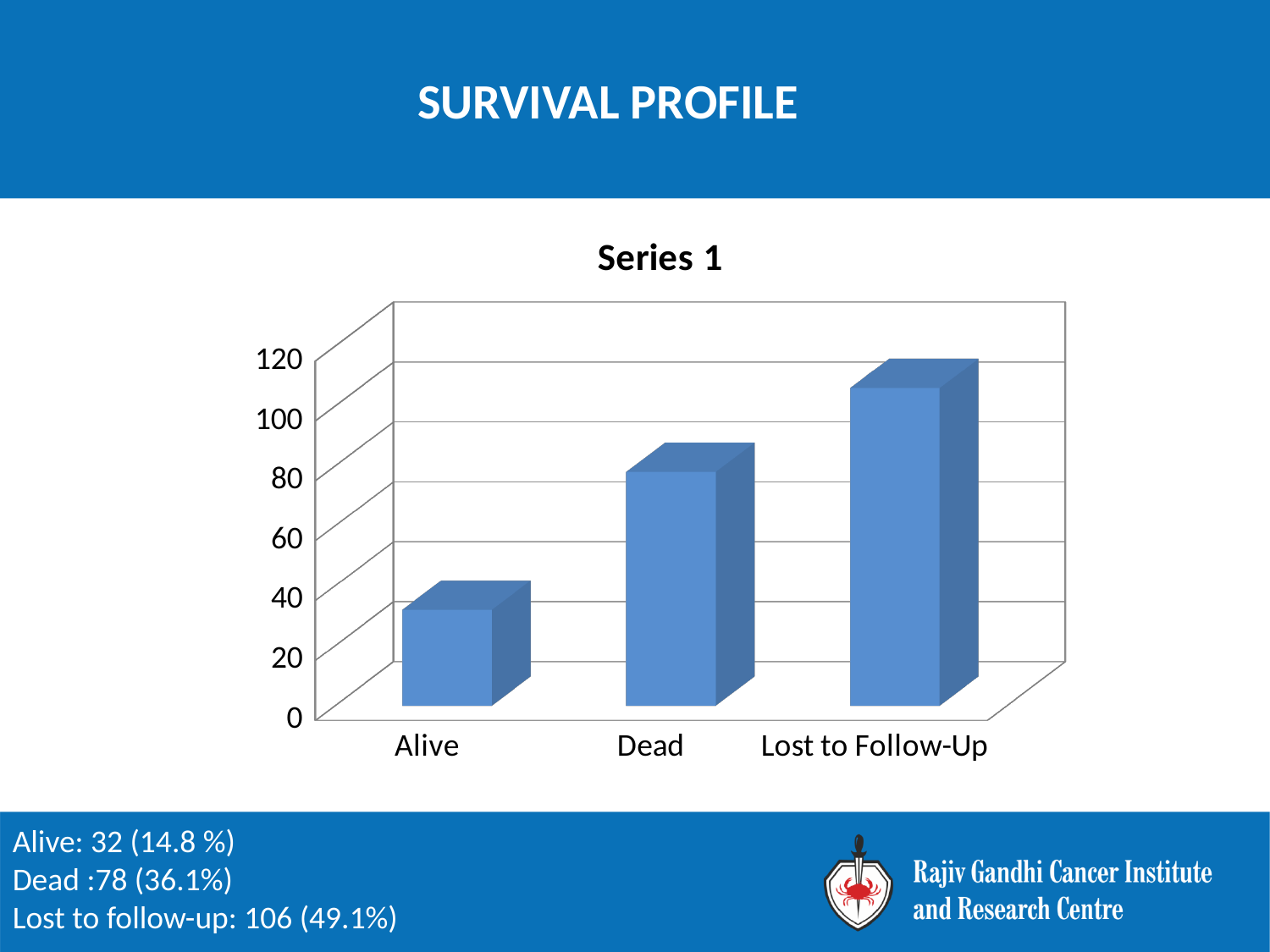
Is the value for Alive greater or less than 40? less Which category has the lowest bar in the chart? Alive According to the text on the slide, how many patients were Alive? 32 Do the bar values rise or fall from Alive to Lost to Follow-Up along the x axis? rise What type of chart is shown on the slide? bar chart According to the text on the slide, what percentage of patients were Lost to follow-up? 49.1% How many categories are shown on the x axis of the chart? 3 Is the value for Dead greater or less than 60? greater Is the bar for Dead taller or shorter than the bar for Alive? taller Which category has the highest bar in the chart? Lost to Follow-Up Is the value for Lost to Follow-Up greater or less than 100? greater What is the title of the chart? Series 1